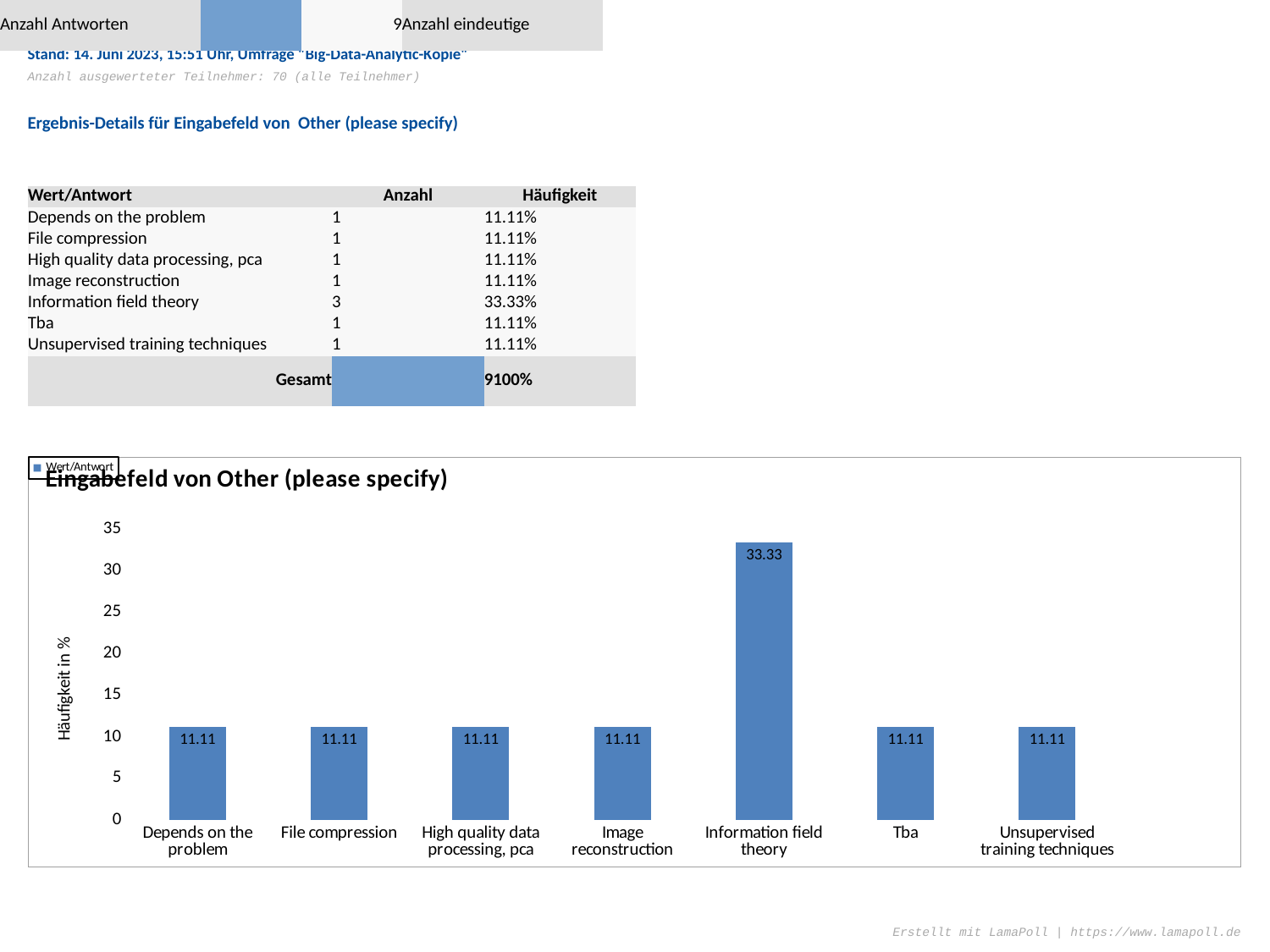
What is the value for Unsupervised training techniques? 11.11 How many categories are shown on the x axis? 7 What is the title of the chart? Eingabefeld von Other (please specify) What kind of chart is shown? bar chart Which is larger, the value for Image reconstruction or the value for Information field theory? Information field theory Is the value for Depends on the problem greater or less than 15? less What is the difference between the values for Information field theory and Tba? 22.22 Is the value for Information field theory greater or less than 30? greater What is the value for Information field theory? 33.33 Which category has the highest value? Information field theory What is the label of the y axis? Häufigkeit in % What is the value for File compression? 11.11